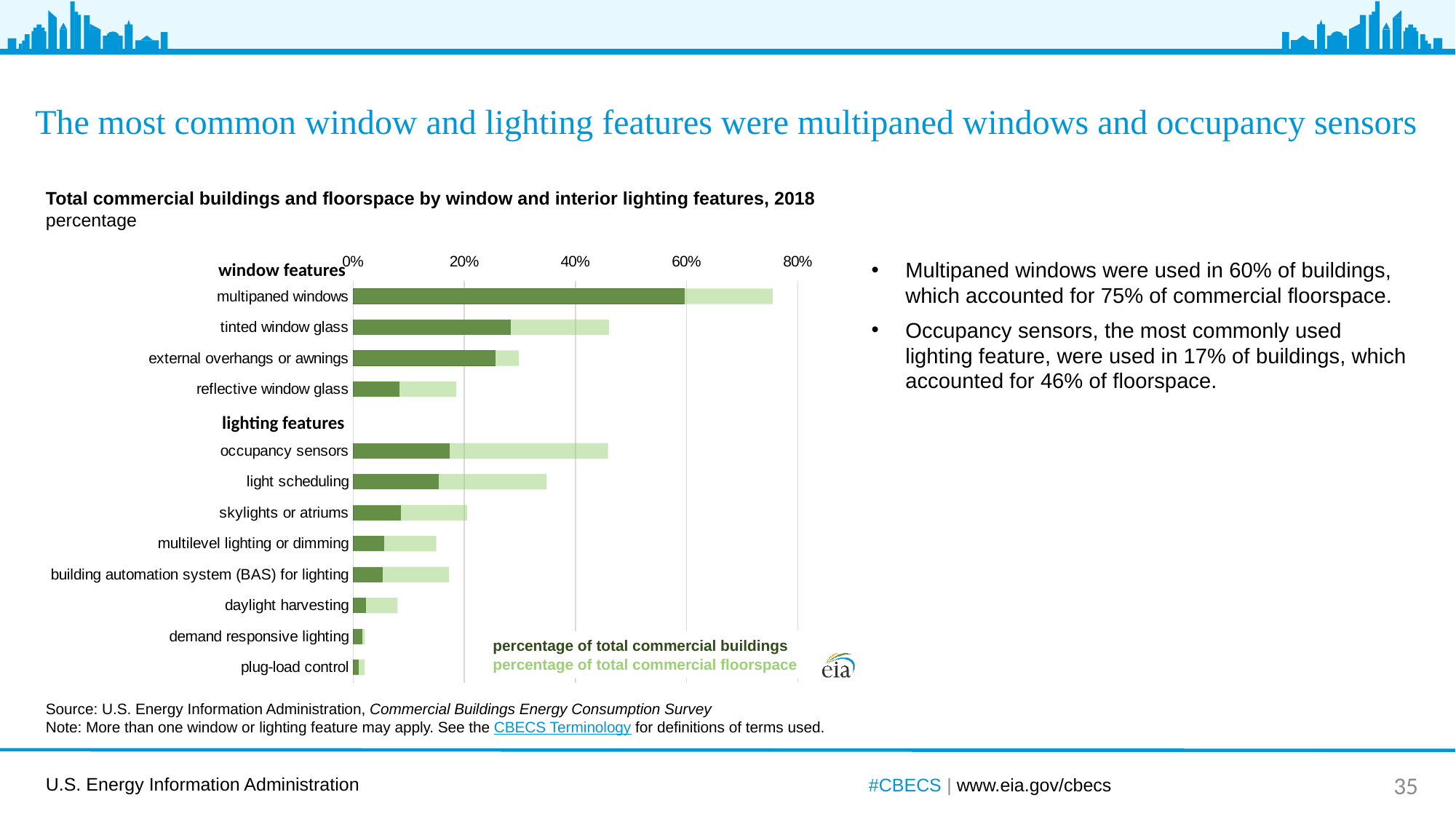
Which colour represents the percentage of total commercial buildings series? dark green What is the difference between the floorspace percentage and the buildings percentage for multipaned windows? 15 percentage points Is the percentage of total commercial buildings with tinted window glass greater or less than 20%? greater What percentage of total commercial floorspace had occupancy sensors? 46% How many series does the chart's legend list? 2 Among the lighting features, which has the highest percentage of total commercial floorspace? occupancy sensors What kind of chart is shown on the slide? bar chart What percentage of total commercial buildings used multipaned windows? 60% Is the percentage of total commercial buildings with reflective window glass greater or less than 20%? less Which feature has the highest percentage of total commercial buildings? multipaned windows Which has a larger percentage of total commercial floorspace: tinted window glass or external overhangs or awnings? tinted window glass How many window and lighting feature categories are plotted in the chart? 12